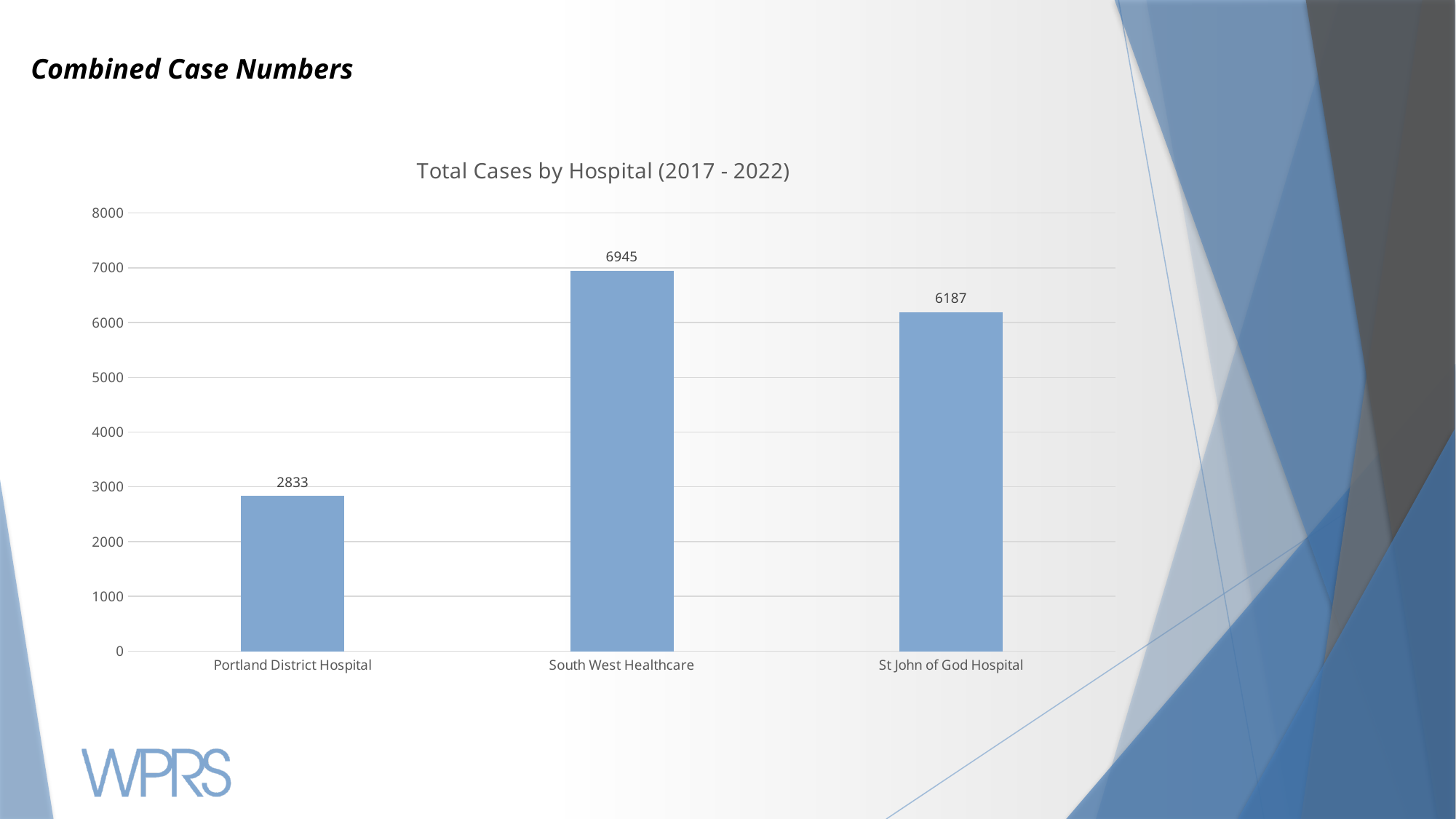
What is the title of the chart? Total Cases by Hospital (2017 - 2022) What is the total number of cases for St John of God Hospital? 6187 What is the difference in total cases between South West Healthcare and St John of God Hospital? 758 What is the total number of cases for Portland District Hospital? 2833 What is the total number of cases for South West Healthcare? 6945 What is the difference in total cases between South West Healthcare and Portland District Hospital? 4112 How many hospitals are shown in the chart? 3 Which has more total cases, St John of God Hospital or Portland District Hospital? St John of God Hospital Which hospital has the highest total number of cases? South West Healthcare What kind of chart is shown on the slide? Bar chart Is the value for St John of God Hospital greater or less than 6000? greater Which hospital has the lowest total number of cases? Portland District Hospital